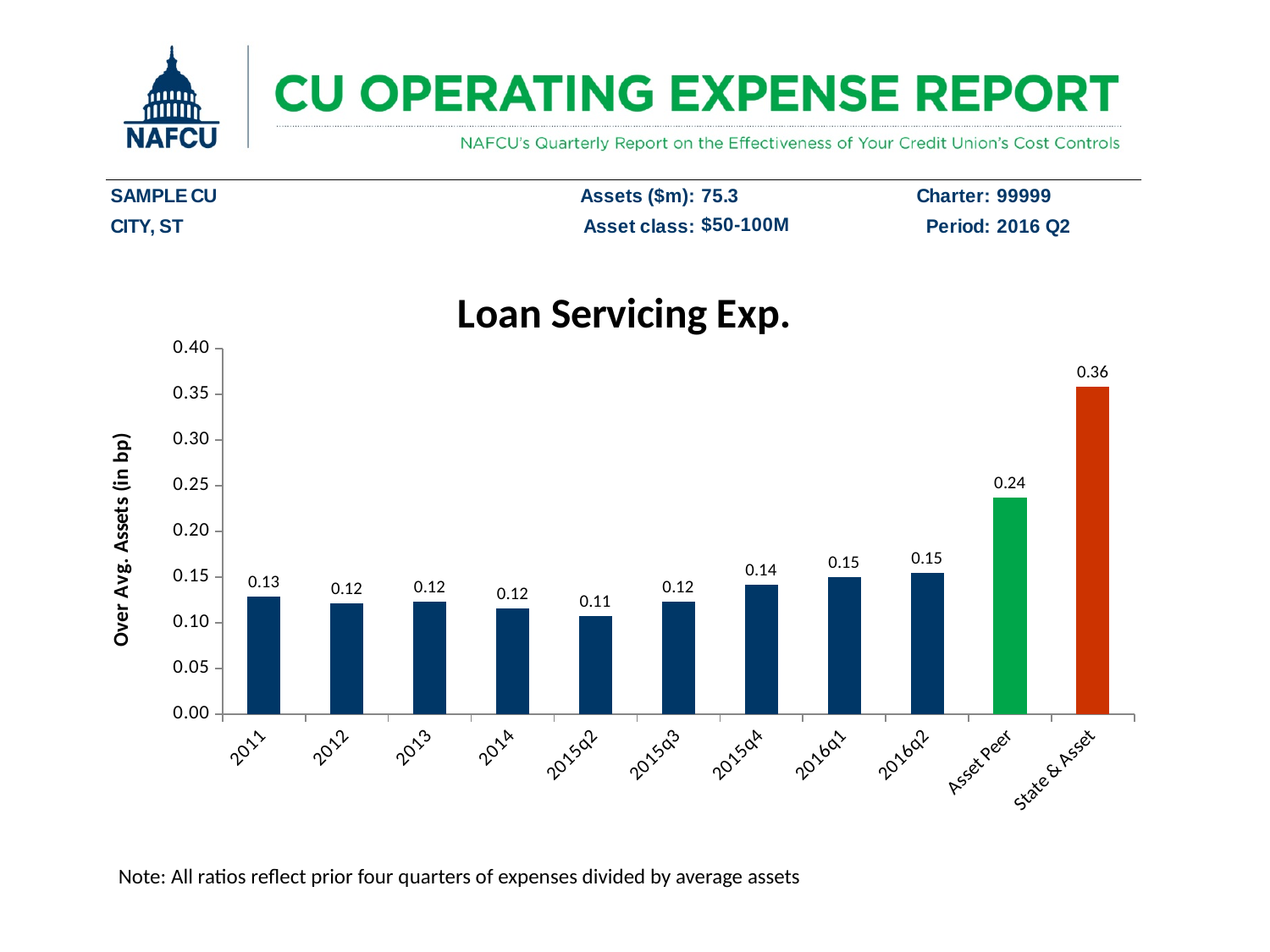
Is the value for Asset Peer in the Loan Servicing Exp. chart greater or less than 0.20? greater Which category has the lowest value in the Loan Servicing Exp. chart? 2015q2 What type of chart is the Loan Servicing Exp. chart? Bar chart What is the value for Asset Peer in the Loan Servicing Exp. chart? 0.24 What is the value for 2016q2 in the Loan Servicing Exp. chart? 0.15 Which category has the highest value in the Loan Servicing Exp. chart? State & Asset What is the label on the vertical axis of the Loan Servicing Exp. chart? Over Avg. Assets (in bp) What is the value for State & Asset in the Loan Servicing Exp. chart? 0.36 How many bars are shown in the Loan Servicing Exp. chart? 11 Which is larger in the Loan Servicing Exp. chart, the value for 2015q4 or the value for 2011? 2015q4 What is the difference between the State & Asset value and the Asset Peer value in the Loan Servicing Exp. chart? 0.12 What is the value for 2015q2 in the Loan Servicing Exp. chart? 0.11